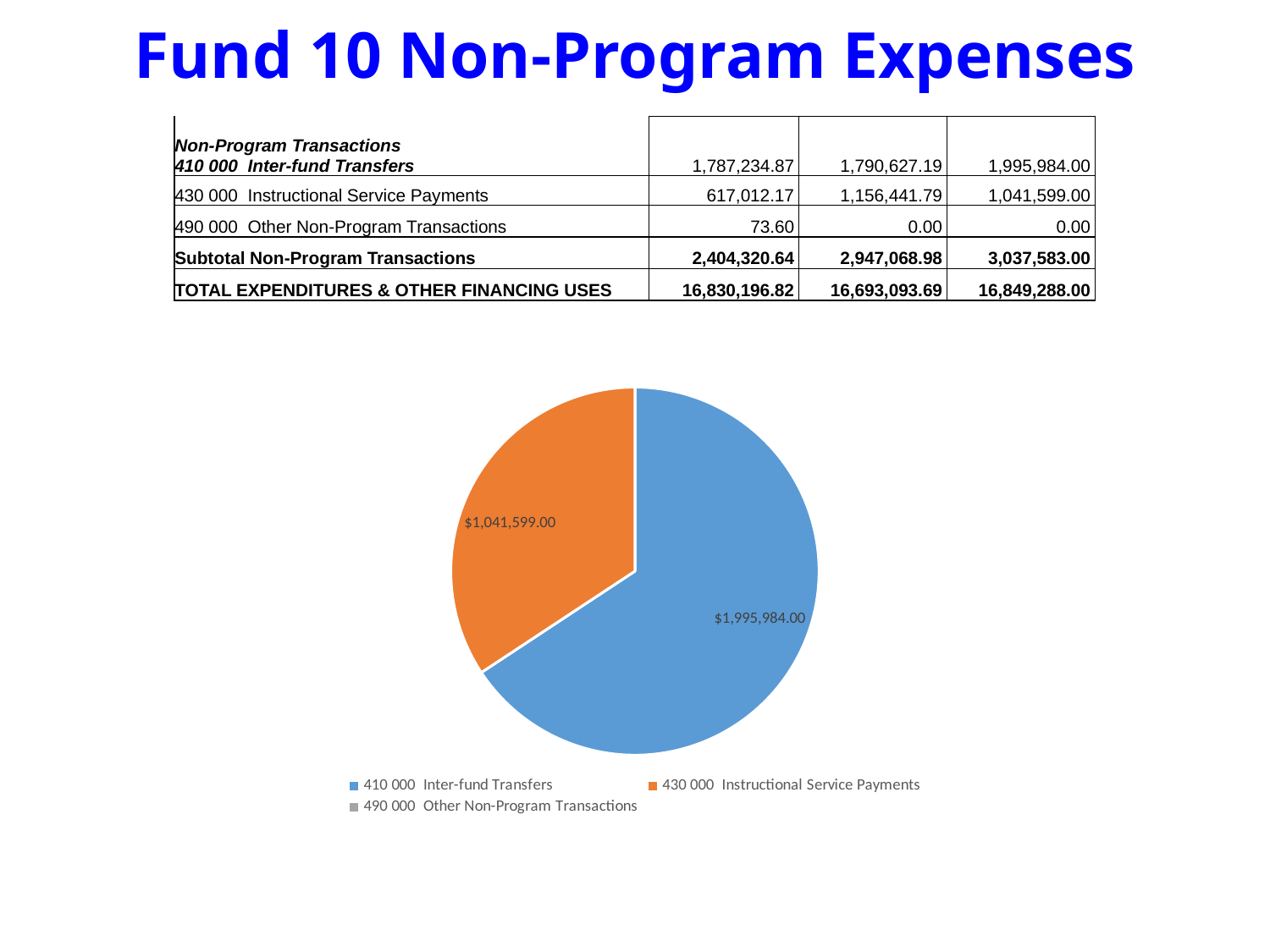
What colour is the slice for 430 000 Instructional Service Payments in the pie chart? orange In the pie chart, is the value for 410 000 Inter-fund Transfers larger or smaller than the value for 430 000 Instructional Service Payments? larger How many entries does the legend of the pie chart list? 3 What is the value shown for 430 000 Instructional Service Payments in the pie chart? $1,041,599.00 Which of the two labelled slices in the pie chart is the smaller one? 430 000 Instructional Service Payments What kind of chart is shown on the slide? pie chart What is the value shown for 410 000 Inter-fund Transfers in the pie chart? $1,995,984.00 What is the difference between the Inter-fund Transfers slice and the Instructional Service Payments slice in the pie chart? $954,385.00 Which legend entry in the pie chart has no visible slice? 490 000 Other Non-Program Transactions How many slices with data labels are visible in the pie chart? 2 Which category has the largest slice in the pie chart? 410 000 Inter-fund Transfers